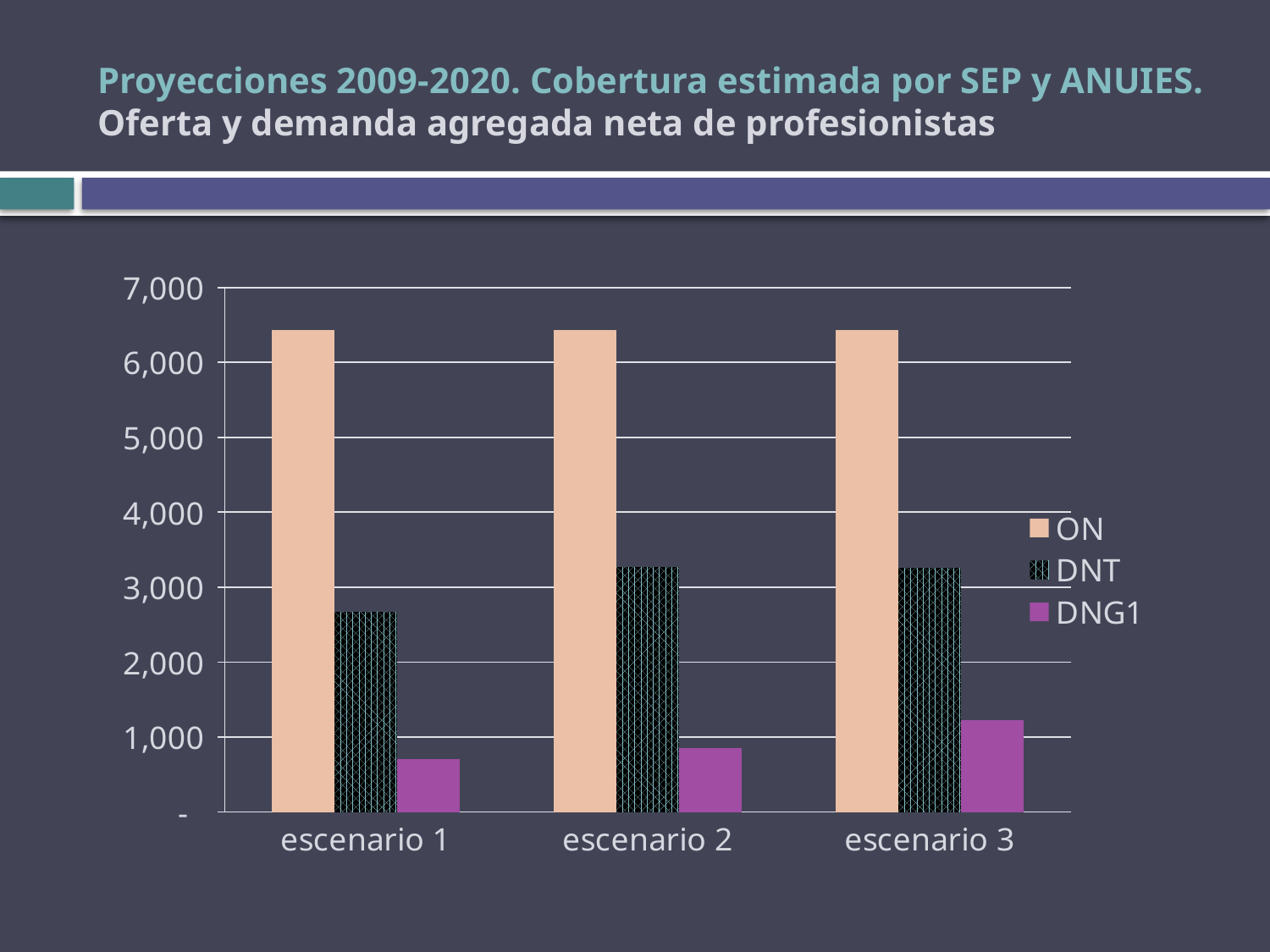
Is the value for ON in escenario 1 greater or less than 6,000? greater Which series has the highest value in escenario 2? ON How many scenarios (categories) are shown on the x axis? 3 Is the value for DNG1 in escenario 3 greater or less than 1,000? greater What kind of chart is shown on the slide? bar chart Is the value for DNG1 in escenario 1 greater or less than 1,000? less Which series has the lowest value in escenario 3? DNG1 Which is larger, DNT in escenario 1 or DNT in escenario 2? DNT in escenario 2 How many series does the legend list? 3 Do the DNG1 values rise or fall from escenario 1 to escenario 3? rise